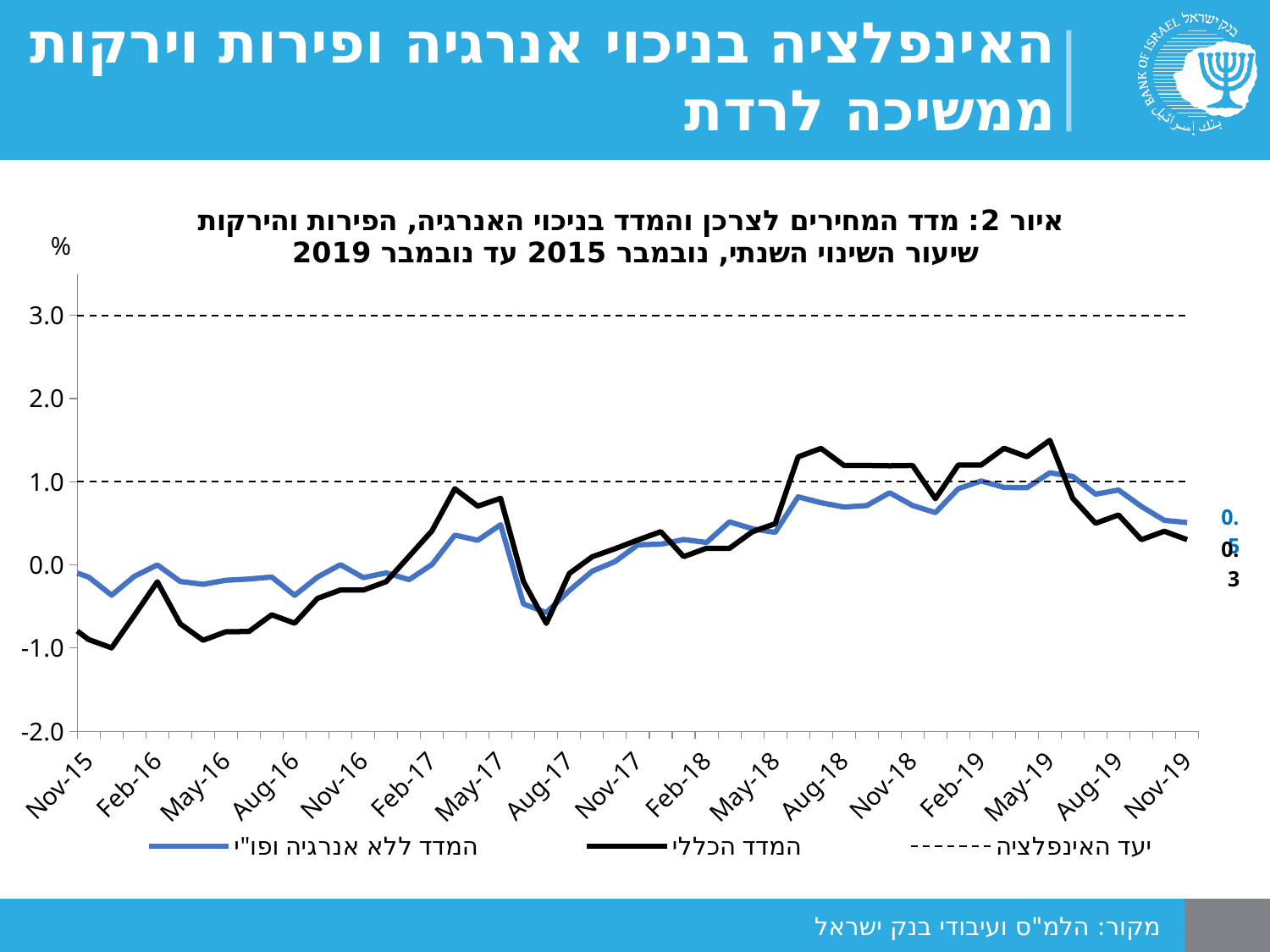
What does the dashed line in the legend represent? יעד האינפלציה What unit is shown on the y axis? % Is the value of המדד הכללי (black line) at Aug-18 greater or less than 1.0? greater At Aug-18, which series is higher: המדד הכללי or המדד ללא אנרגיה ופו"י? המדד הכללי Is the value of המדד הכללי (black line) at Nov-15 greater or less than 0.0? less At Nov-15, which series is higher: המדד הכללי or המדד ללא אנרגיה ופו"י? המדד ללא אנרגיה ופו"י What kind of chart is shown on the slide? line chart Is the value of המדד ללא אנרגיה ופו"י (blue line) at Aug-17 greater or less than 0.0? less How many entries does the legend list? 3 Does המדד הכללי (black line) rise or fall between May-19 and Nov-19? fall